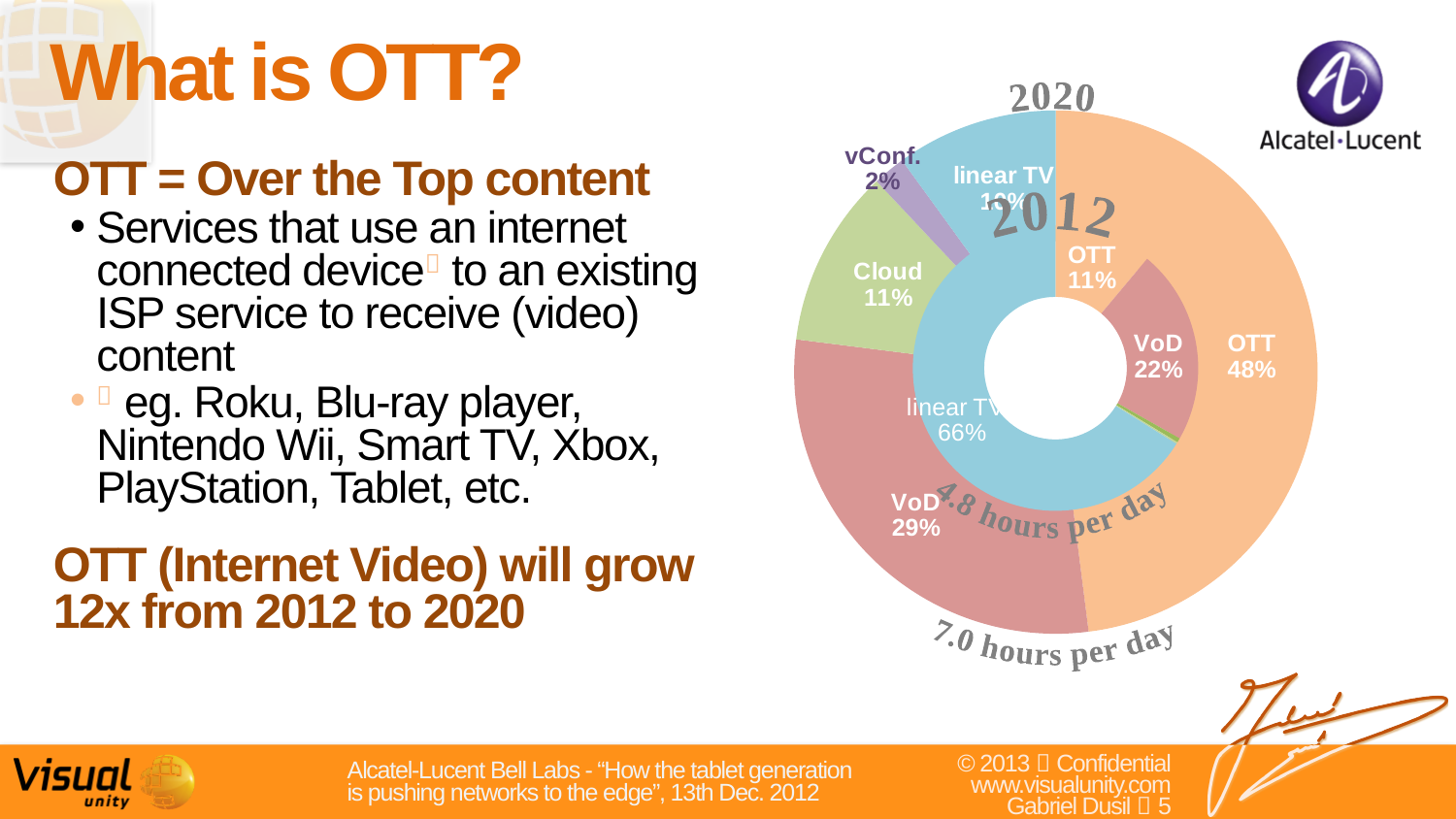
In the 2020 ring of the chart, what share does vConf. have? 2% In the 2020 ring of the chart, what share does Cloud have? 11% In the 2020 ring of the chart, what share does VoD have? 29% In the 2020 ring of the chart, what share does OTT have? 48% According to the chart, how many hours per day are associated with the 2020 ring? 7.0 hours per day What kind of chart is shown on the slide? Doughnut (pie) chart In the 2012 ring of the chart, what share does VoD have? 22% By how many percentage points does the OTT share in 2020 exceed the OTT share in 2012? 37 percentage points In the 2012 ring of the chart, what share does linear TV have? 66% Which category has the largest share in the 2012 ring of the chart? linear TV Which labelled category has the smallest share in the 2020 ring of the chart? vConf. Which category has the largest share in the 2020 ring of the chart? OTT